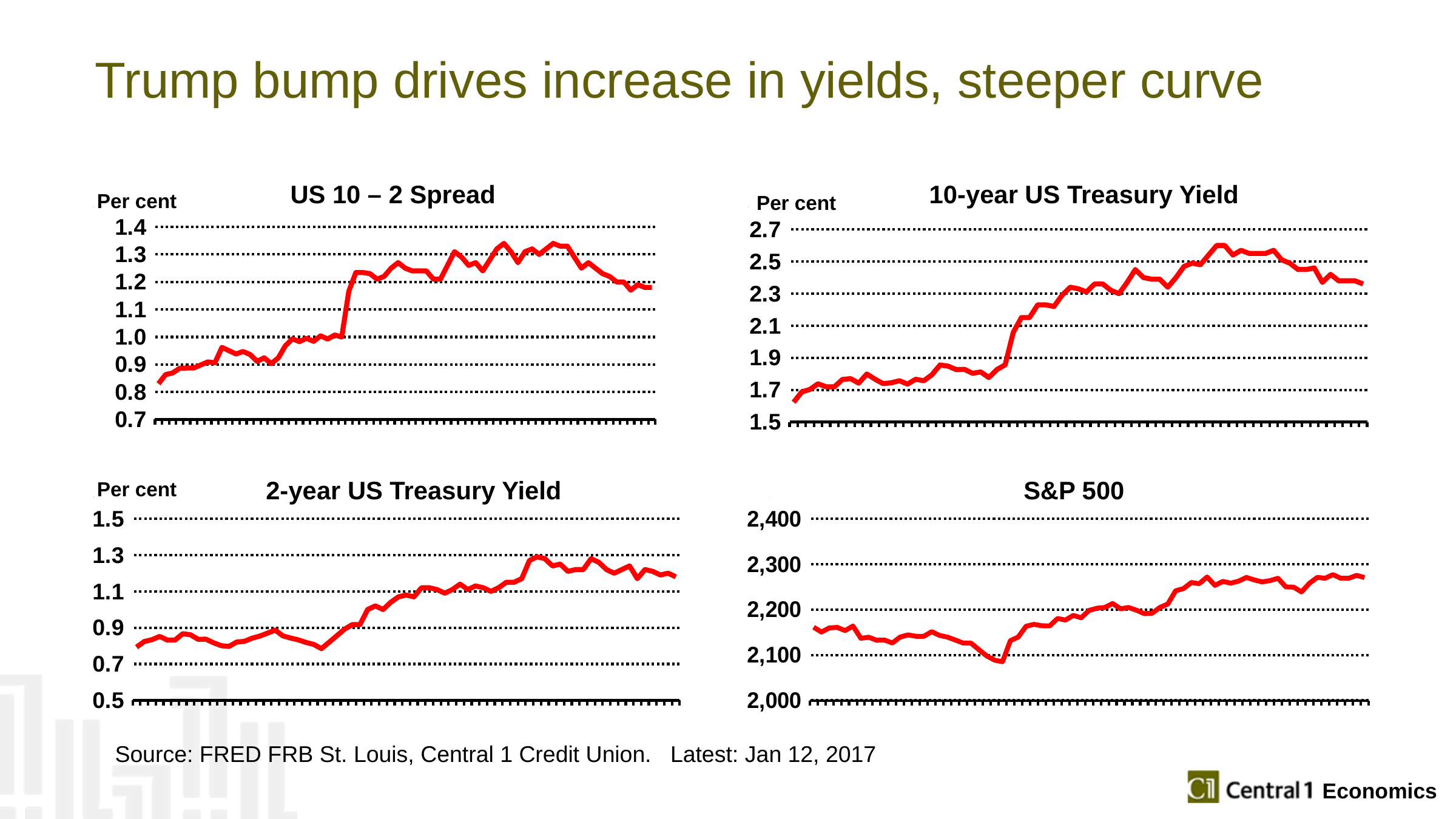
In the 10-year US Treasury Yield chart, do the values overall rise or fall from left to right? rise In the 2-year US Treasury Yield chart, is the value at the start of the line greater or less than 0.9? less In the 2-year US Treasury Yield chart, do the values overall rise or fall from left to right? rise In the US 10 – 2 Spread chart, is the highest point of the line greater or less than 1.4? less What kind of chart is the US 10 – 2 Spread chart? line chart In the 10-year US Treasury Yield chart, is the value at the start of the line greater or less than 1.9? less What unit label is shown on the vertical axis of the 10-year US Treasury Yield chart? Per cent In the S&P 500 chart, do the values overall rise or fall from left to right? rise What is the title of the chart in the bottom-right of the slide? S&P 500